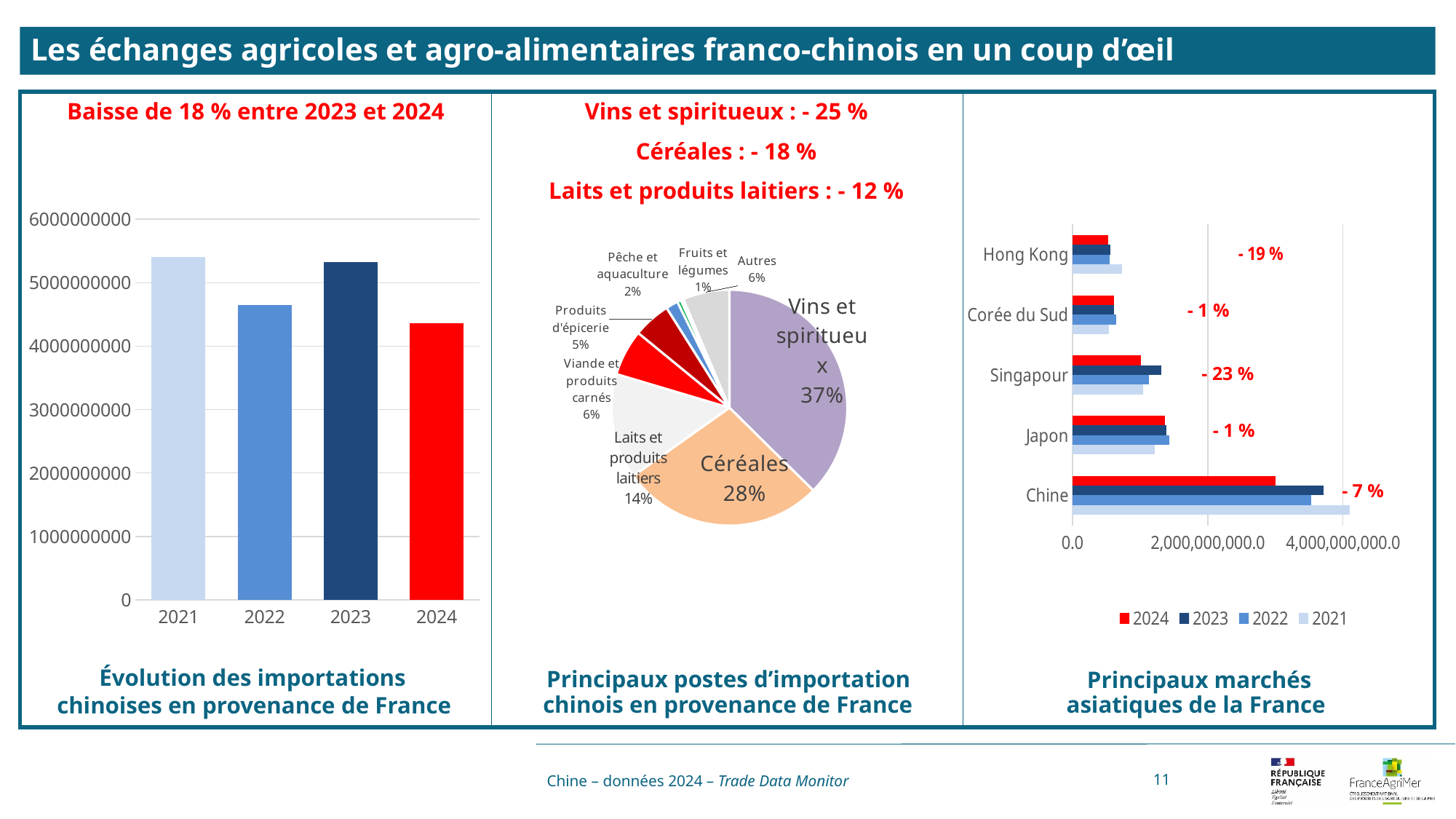
In the chart 'Évolution des importations chinoises en provenance de France', which is larger, the value for 2023 or the value for 2022? 2023 In the pie chart 'Principaux postes d'importation chinois en provenance de France', what is the difference in percentage points between Vins et spiritueux and Laits et produits laitiers? 23 What kind of chart is 'Évolution des importations chinoises en provenance de France'? bar chart In the pie chart 'Principaux postes d'importation chinois en provenance de France', what share does Céréales have? 28% In the chart 'Évolution des importations chinoises en provenance de France', is the value for 2022 greater or less than 4000000000? greater In the chart 'Principaux marchés asiatiques de la France', is the 2024 value for Chine greater or less than 2,000,000,000.0? greater How many slices does the pie chart 'Principaux postes d'importation chinois en provenance de France' have? 8 In the chart 'Évolution des importations chinoises en provenance de France', which year has the lowest value? 2024 How many series does the legend of the chart 'Principaux marchés asiatiques de la France' list? 4 In the chart 'Principaux marchés asiatiques de la France', what percentage change is annotated next to Singapour? - 23 % In the chart 'Évolution des importations chinoises en provenance de France', is the value for 2021 greater or less than 5000000000? greater In the pie chart 'Principaux postes d'importation chinois en provenance de France', which slice is the largest? Vins et spiritueux